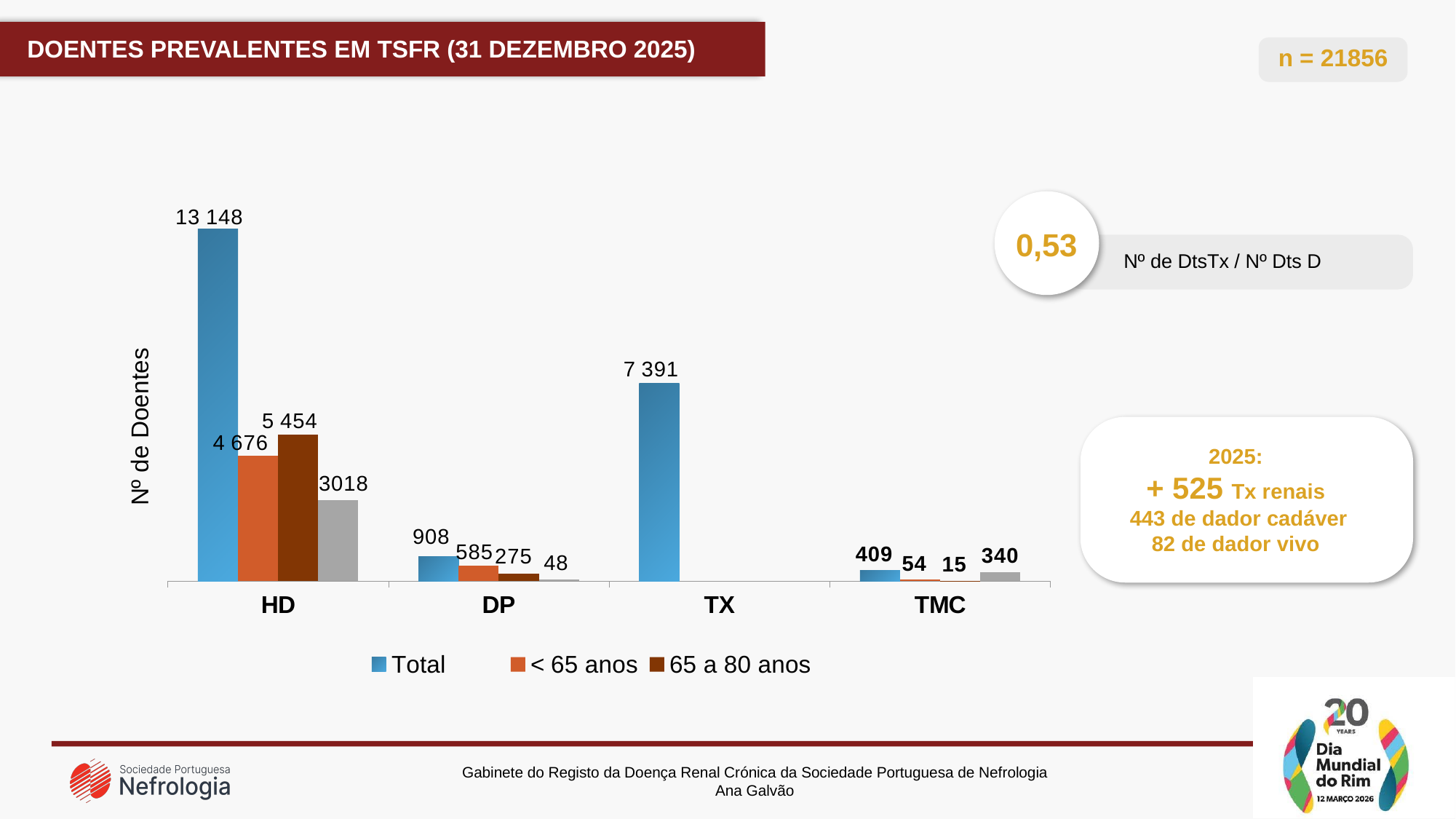
What is the Total value for TX? 7 391 What is the value for < 65 anos in the TMC category? 54 How many categories are shown on the x axis? 4 What is the value for < 65 anos in the HD category? 4 676 What kind of chart is shown on the slide? Bar chart In the HD category, which is larger: < 65 anos or 65 a 80 anos? 65 a 80 anos What is the Total value for HD? 13 148 Which category has the highest Total value? HD How many series does the legend list? 3 What is the difference between the Total values for HD and TX? 5 757 Which category has the lowest Total value? TMC What is the value for 65 a 80 anos in the DP category? 275